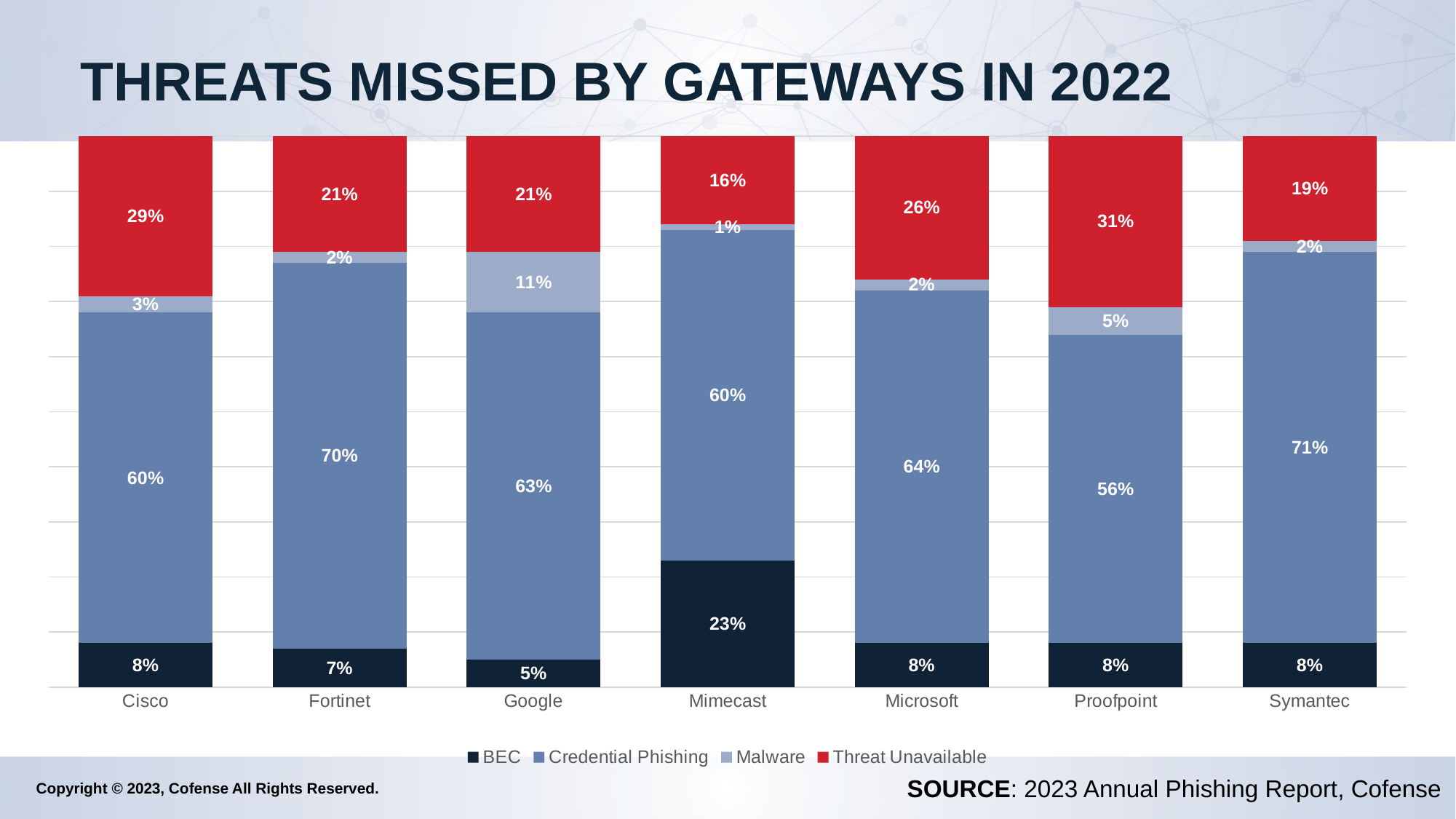
Which is larger, the Credential Phishing value for Microsoft or for Proofpoint? Microsoft What is the Threat Unavailable value for Proofpoint? 31% What is the BEC value for Mimecast? 23% How many gateways are shown on the x axis? 7 Which gateway has the highest Credential Phishing value? Symantec What is the Malware value for Google? 11% What kind of chart is shown on the slide? Stacked bar chart Which gateway has the lowest Malware value? Mimecast What is the Credential Phishing value for Fortinet? 70% How many series does the legend list? 4 Which gateway has the highest BEC value? Mimecast What is the difference between the Threat Unavailable values for Cisco and Mimecast? 13%